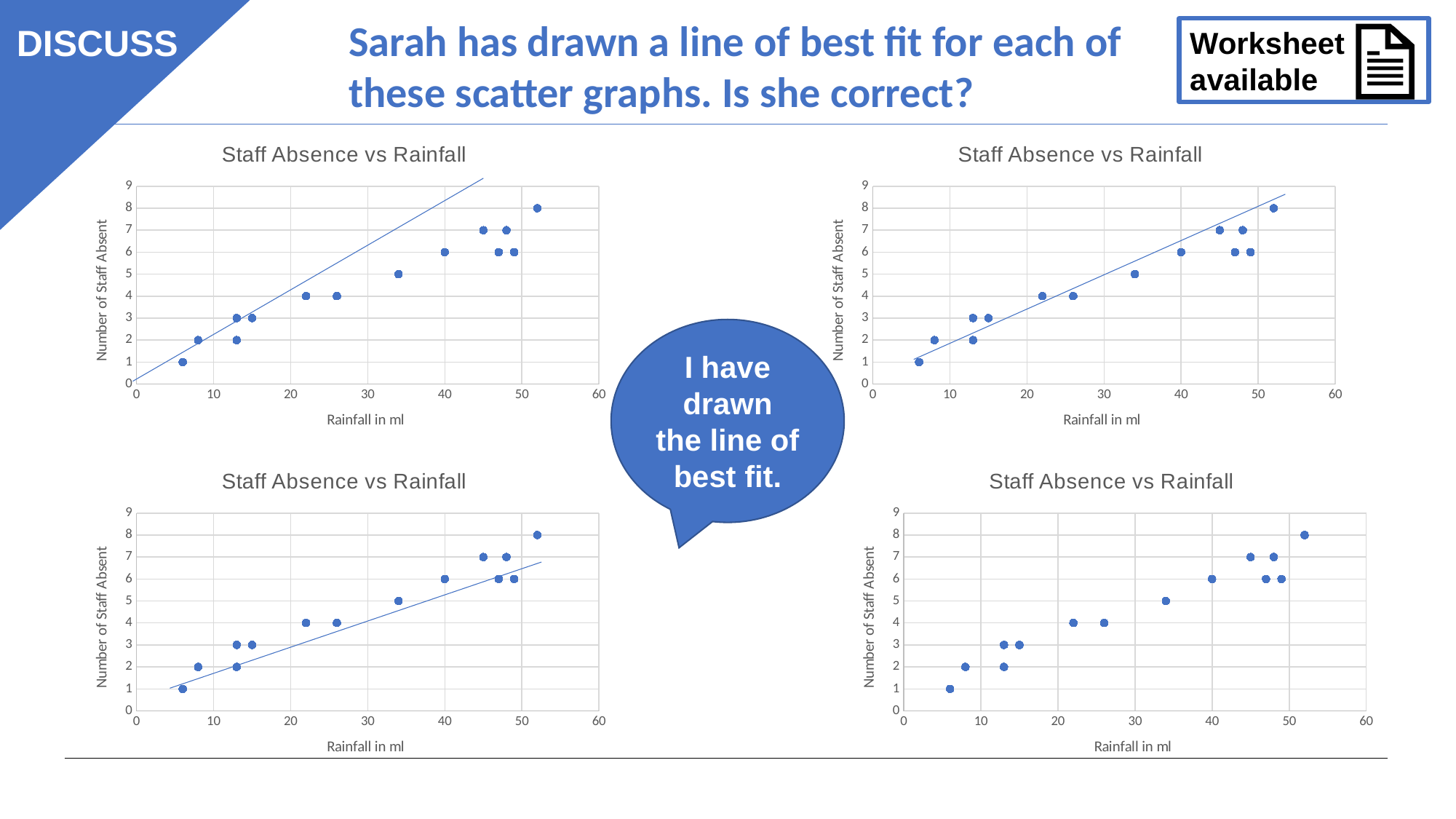
What kind of chart is the top-left chart on the slide? scatter chart In the bottom-right chart, is the rainfall value for the point with 1 staff absent greater or less than 10? less In the top-left chart, what is the highest number of staff absent shown by any point? 8 In the top-left chart, how many staff are absent at the point where rainfall is 40 ml? 6 In the bottom-left chart, what is the label on the x axis? Rainfall in ml In the top-right chart, is the rainfall value for the point with 5 staff absent greater or less than 30? greater In the bottom-right chart, do the number of staff absent values generally rise or fall as rainfall increases? rise What is the title of the top-right chart? Staff Absence vs Rainfall In the top-left chart, which is larger: the number of staff absent at 40 ml of rainfall or at 52 ml of rainfall? 52 ml In the top-right chart, what is the lowest number of staff absent shown by any point? 1 How many data points are plotted in the bottom-right chart? 14 In the bottom-left chart, is the rainfall value for the point with 8 staff absent greater or less than 50? greater